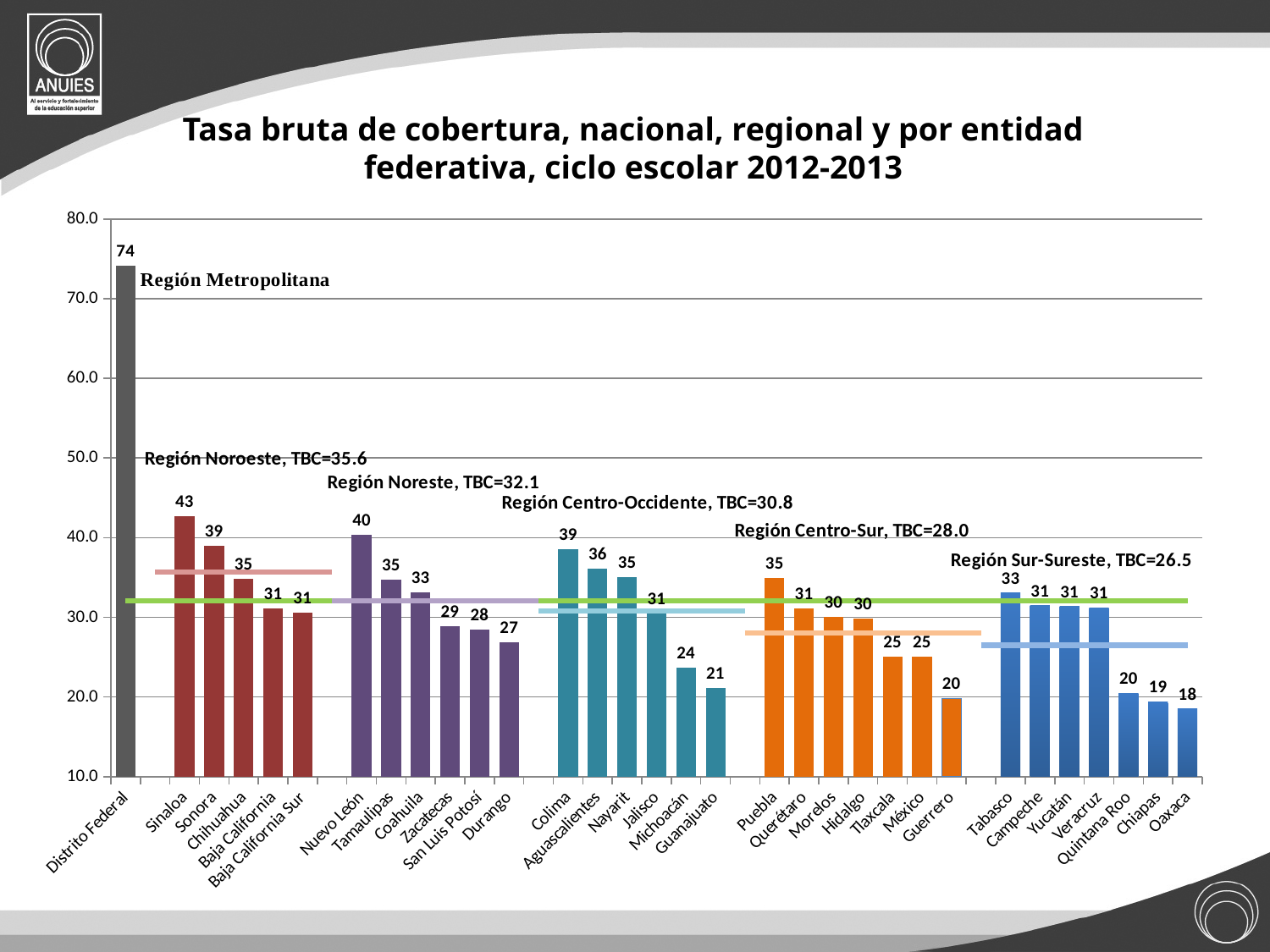
How many states or entities are plotted as bars on the chart? 32 What is the value for Sinaloa? 43 What TBC value is given for Región Noroeste? 35.6 What is the difference between the values for Sinaloa and Oaxaca? 25 What kind of chart is shown on the slide? bar chart Which category has the highest value on the chart? Distrito Federal Which is larger, the value for Colima or the value for Puebla? Colima Is the value for Guerrero greater or less than 30? less What is the value for Distrito Federal? 74 What TBC value is given for Región Sur-Sureste? 26.5 Which state has the lowest value on the chart? Oaxaca What is the value for Nuevo León? 40